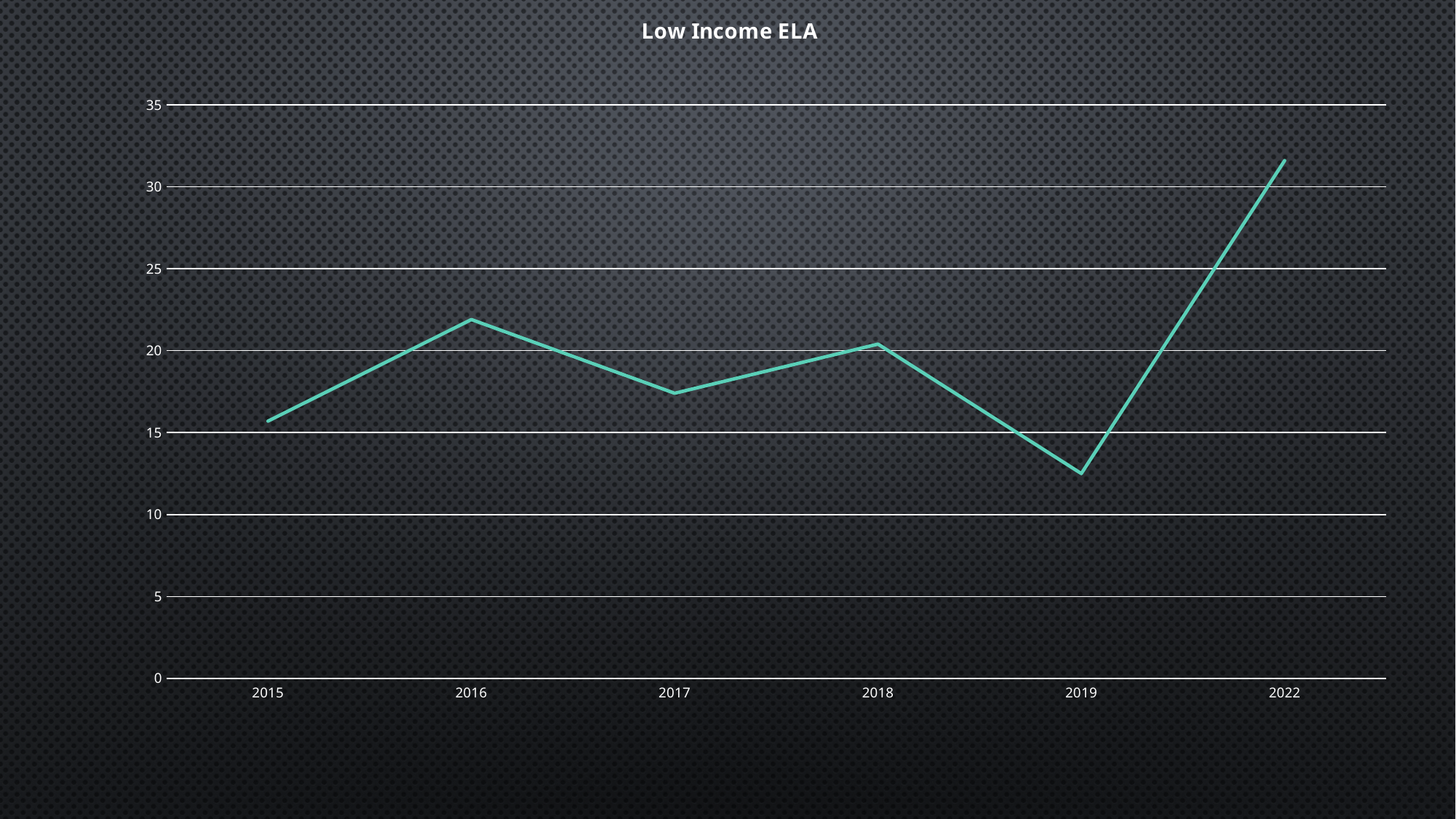
Is the value for 2022 greater or less than 30? greater Does the line rise or fall between 2019 and 2022? rise Which year has the lowest value? 2019 Which year has the highest value? 2022 Which is larger, the value for 2016 or the value for 2018? 2016 What is the title of the chart? Low Income ELA Which is larger, the value for 2015 or the value for 2017? 2017 Is the value for 2019 greater or less than 15? less How many years are plotted along the x axis? 6 Is the value for 2017 greater or less than 20? less What kind of chart is shown on the slide? line chart